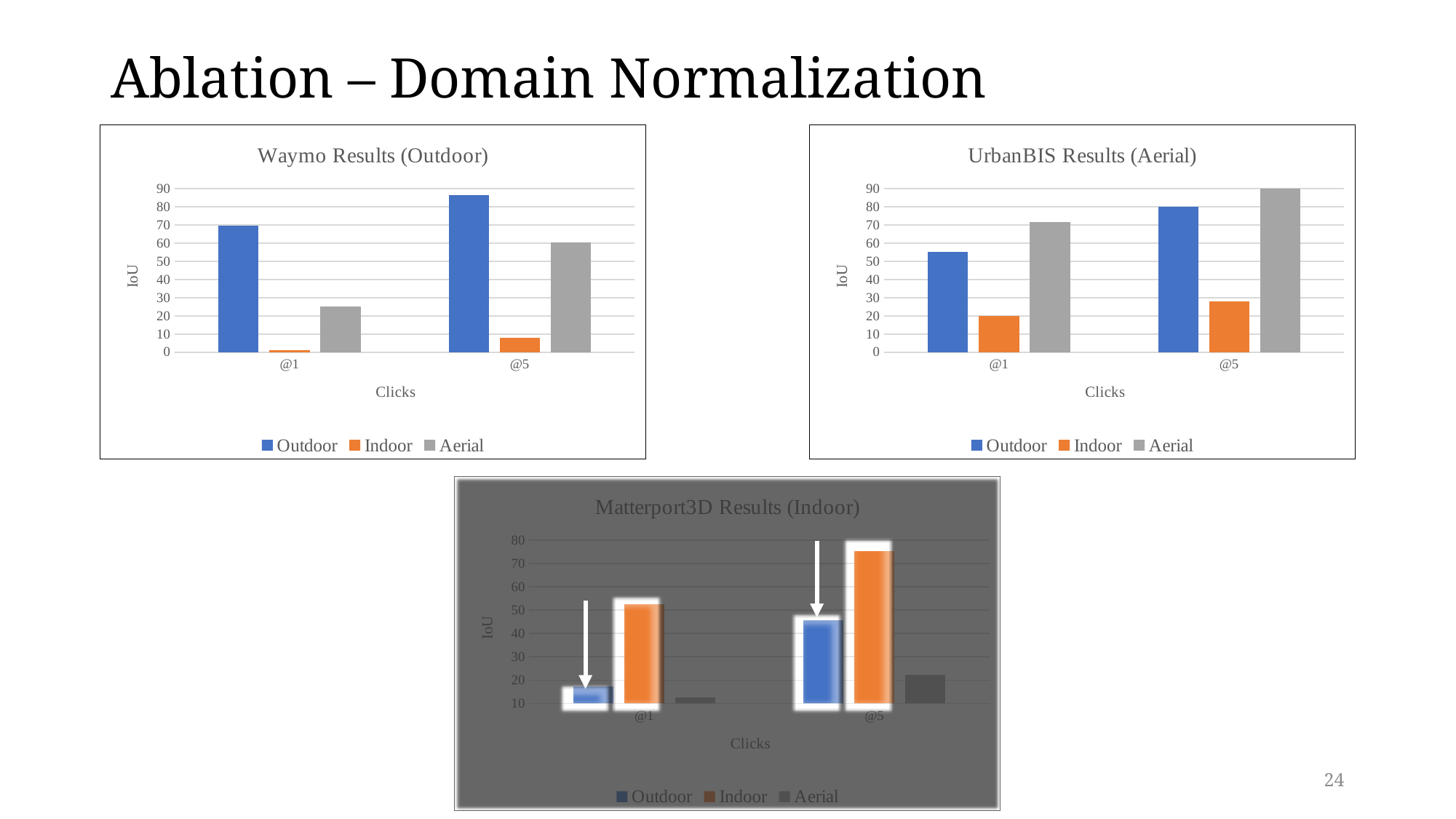
In the Matterport3D Results (Indoor) chart, is the Indoor IoU at @5 greater or less than 70? greater In the UrbanBIS Results (Aerial) chart, which is larger at @1: the Outdoor IoU or the Aerial IoU? Aerial In the Matterport3D Results (Indoor) chart, does the Outdoor IoU rise or fall from @1 to @5? rise In the UrbanBIS Results (Aerial) chart, is the Outdoor IoU at @1 greater or less than 50? greater How many series does the legend of the UrbanBIS Results (Aerial) chart list? 3 In the Waymo Results (Outdoor) chart, which series has the lowest IoU at @1? Indoor In the Waymo Results (Outdoor) chart, which series has the highest IoU at @5? Outdoor In the Waymo Results (Outdoor) chart, is the Outdoor IoU at @5 greater or less than 80? greater What kind of chart is the Waymo Results (Outdoor) chart? bar chart In the UrbanBIS Results (Aerial) chart, which series has the highest IoU at @5? Aerial In the Matterport3D Results (Indoor) chart, which series has the highest IoU at @5? Indoor